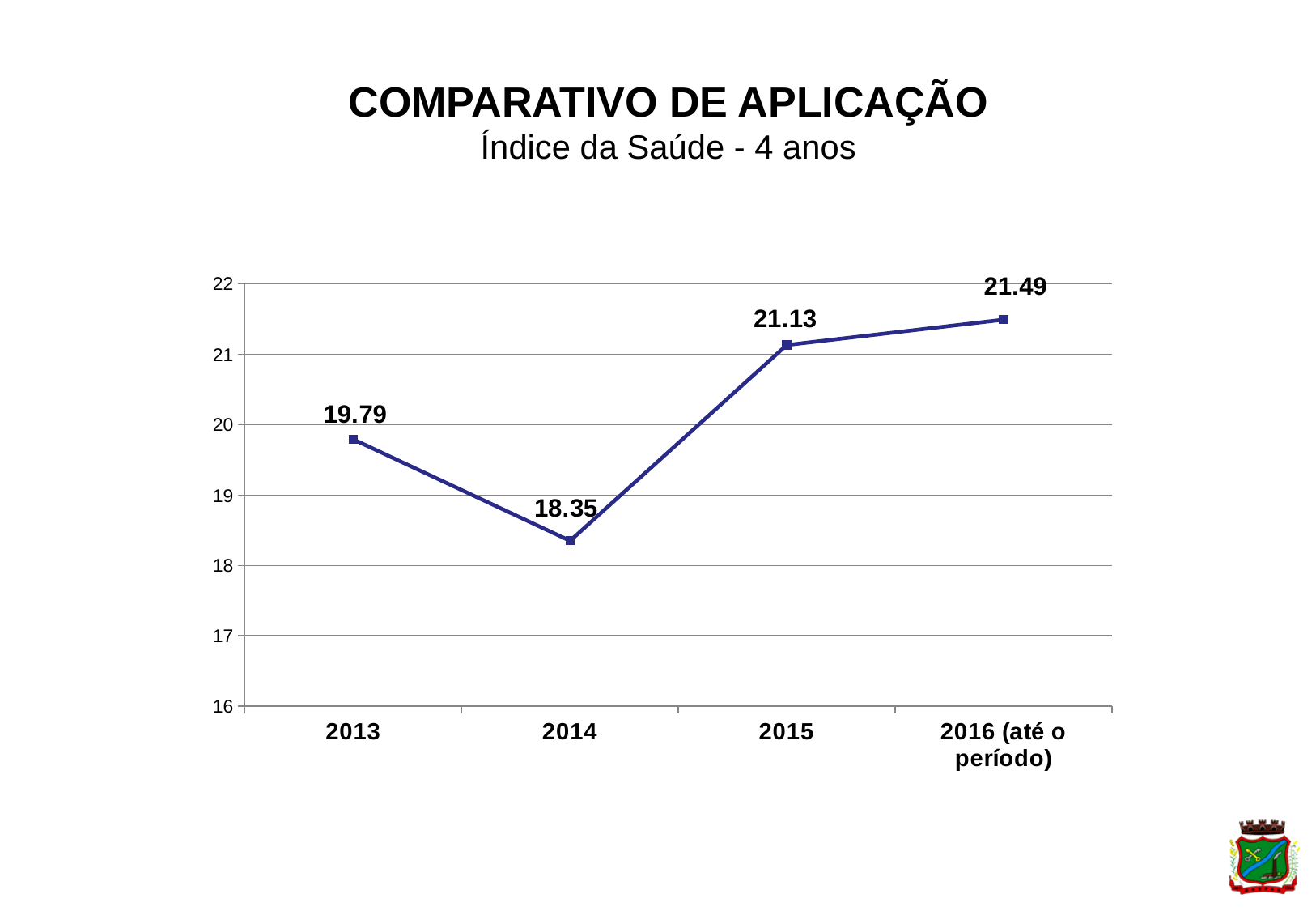
Which year has the lowest value? 2014 What is the value for 2015? 21.13 Which year has the highest value? 2016 (até o período) What is the value for 2014? 18.35 What is the difference between the values for 2015 and 2014? 2.78 Which is larger, the value for 2013 or the value for 2015? 2015 How many data points are plotted on the chart? 4 Is the value for 2014 greater or less than 19? less What kind of chart is shown on the slide? line chart What is the value for 2016 (até o período)? 21.49 What is the value for 2013? 19.79 Do the values rise or fall from 2014 to 2016 (até o período)? rise